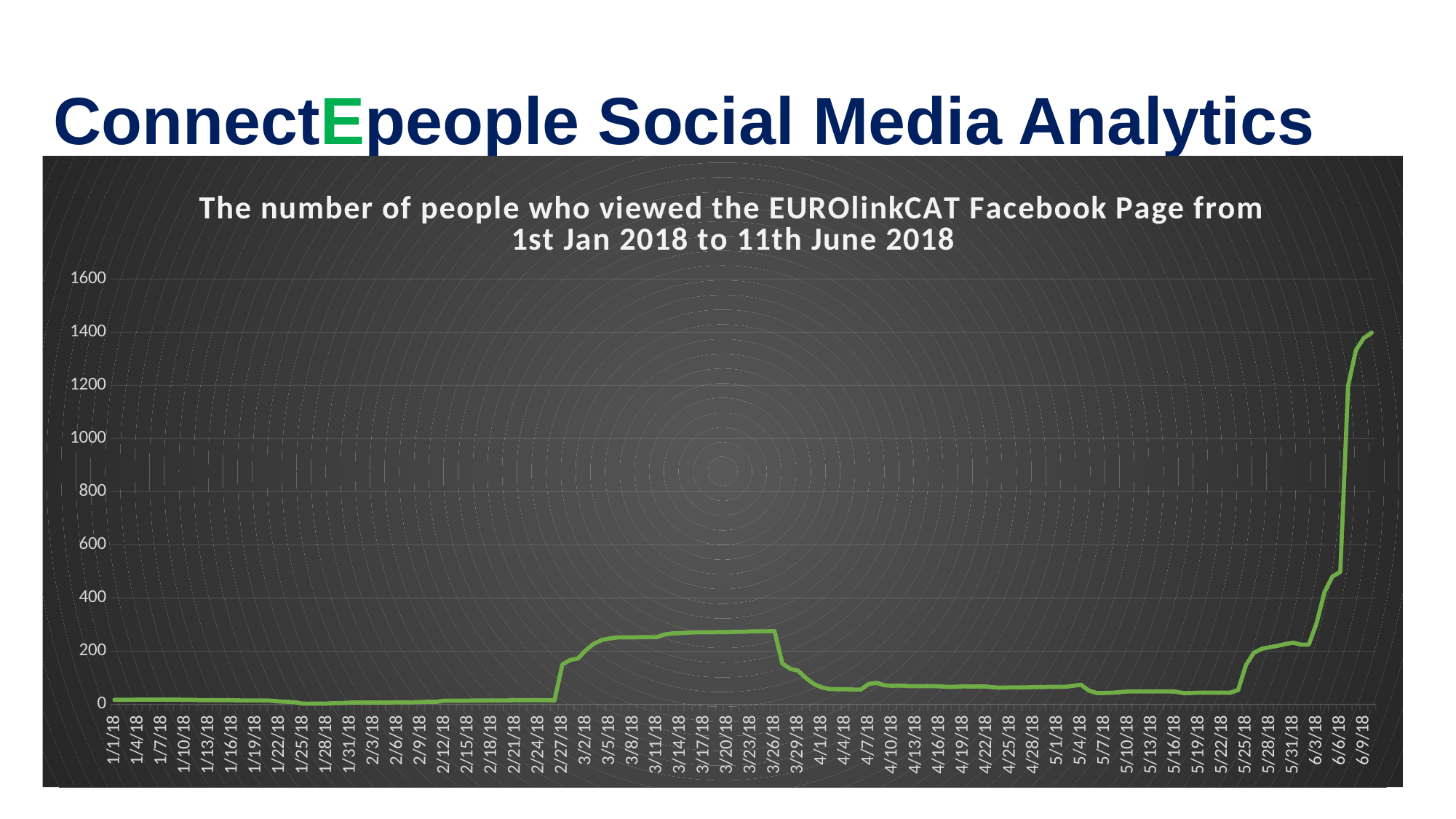
Overall, does the number of page views rise or fall from the start of the period to the end? rise What kind of chart is shown on the slide? line chart Is the value for 3/20/18 greater or less than 200? greater Is the value for 4/16/18 greater or less than 200? less Is the value for 1/1/18 greater or less than 200? less What is the title of the chart? The number of people who viewed the EUROlinkCAT Facebook Page from 1st Jan 2018 to 11th June 2018 In which month does the line reach its highest value? June What colour is the line plotted on the chart? green Which date has the larger value, 6/9/18 or 3/20/18? 6/9/18 Which date has the larger value, 3/20/18 or 4/16/18? 3/20/18